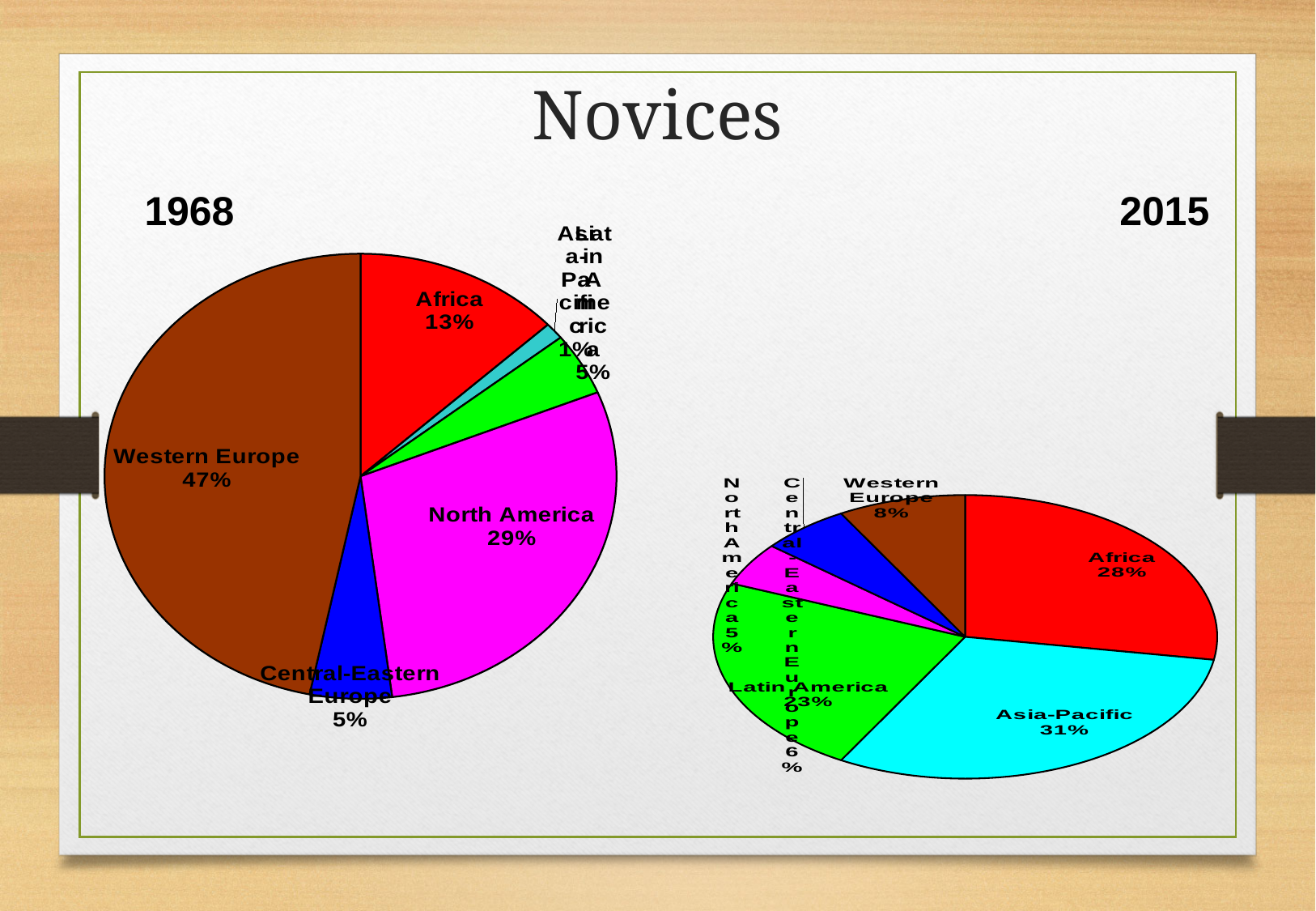
In the 1968 pie chart, how many percentage points larger is Western Europe's share than North America's? 18 percentage points In the 1968 pie chart, what share does North America have? 29% In the 2015 pie chart, what share does Western Europe have? 8% In the 1968 pie chart, which region has the largest slice? Western Europe In the 2015 pie chart, what share does Africa have? 28% What kind of charts are shown on the slide? Pie charts In the 2015 pie chart, what share does Asia-Pacific have? 31% In the 2015 pie chart, which region has the largest slice? Asia-Pacific In the 1968 pie chart, what share does Western Europe have? 47% In the 2015 pie chart, what share does Latin America have? 23% In the 1968 pie chart, what share does Central-Eastern Europe have? 5% In the 1968 pie chart, what share does Africa have? 13%